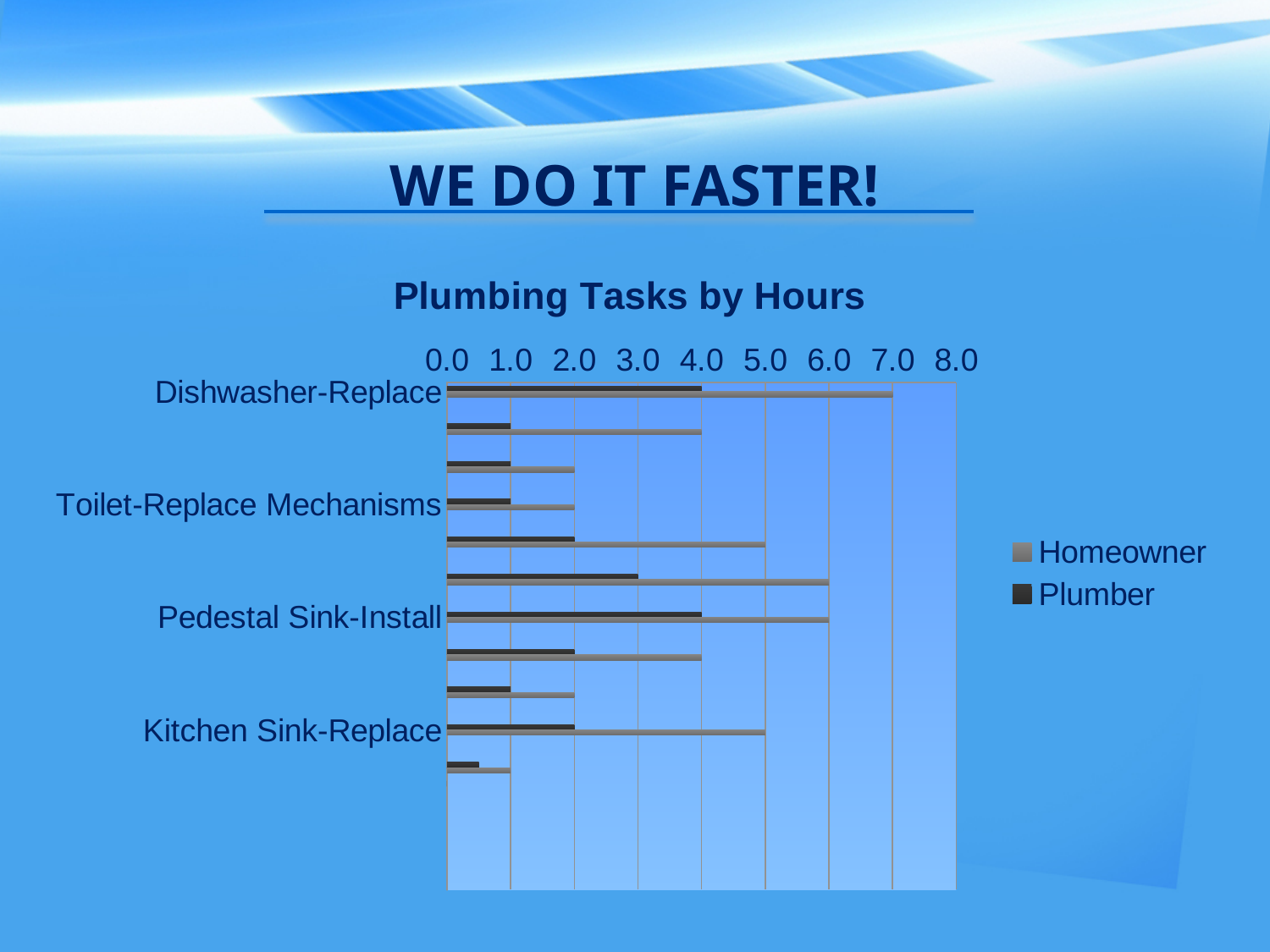
What is the Plumber value for Dishwasher-Replace? 4.0 Is the Plumber value for Pedestal Sink-Install greater or less than 3.0? greater Is the Plumber value for Kitchen Sink-Replace greater or less than 3.0? less What is the Homeowner value for Dishwasher-Replace? 7.0 Which two series are listed in the chart legend? Homeowner and Plumber Is the Homeowner value for Kitchen Sink-Replace greater or less than 4.0? greater How many series does the legend list? 2 For Dishwasher-Replace, which series has the larger value, Homeowner or Plumber? Homeowner What kind of chart is shown on the slide? Bar chart Which has the higher Homeowner value, Dishwasher-Replace or Pedestal Sink-Install? Dishwasher-Replace What is the title of the chart? Plumbing Tasks by Hours